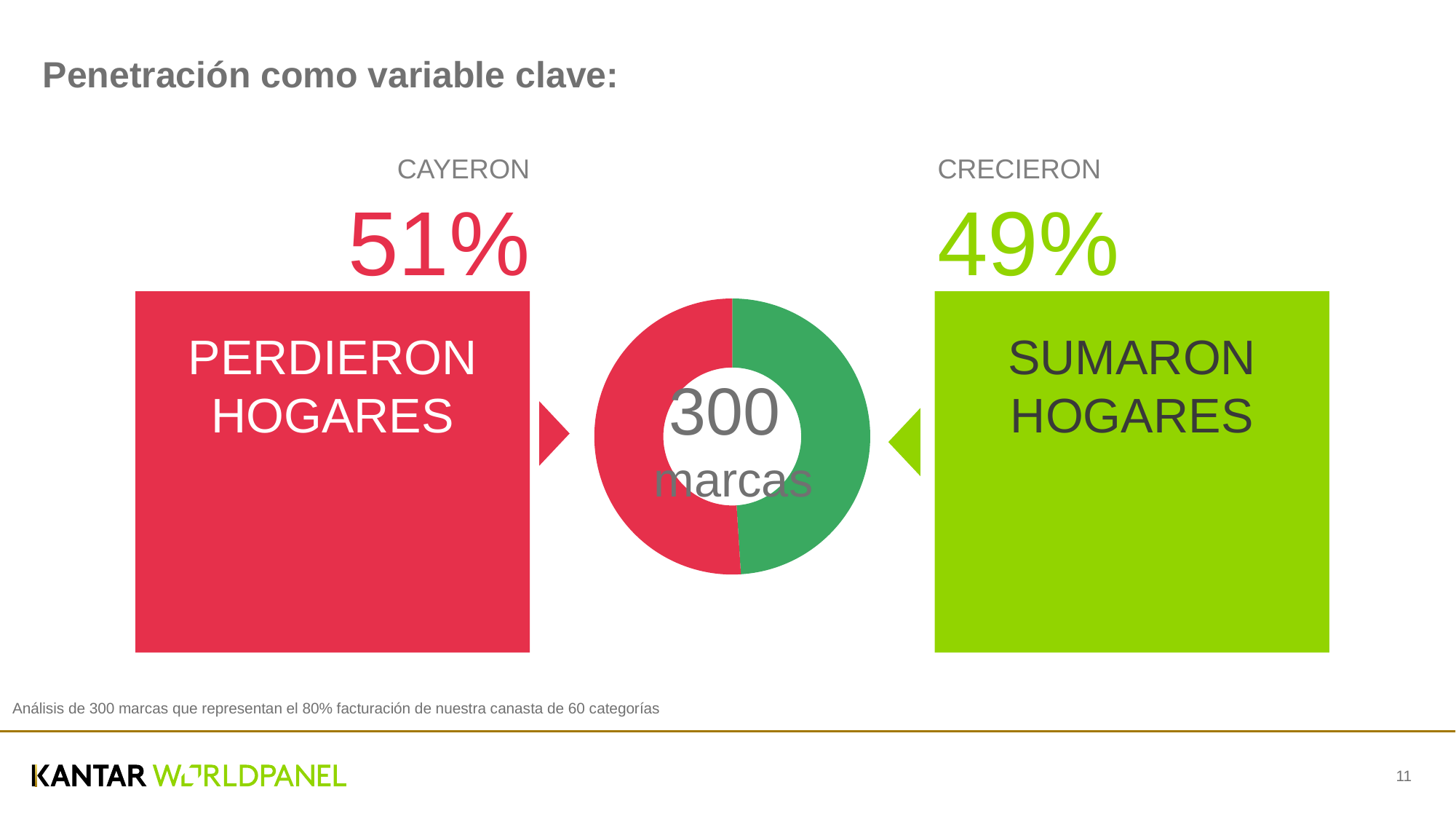
What share of brands fell (CAYERON) according to the slide? 51% What is the share of the donut chart taken by the brands that lost households (PERDIERON HOGARES)? 51% Which slice of the donut chart is the smallest? CRECIERON (49%) What kind of chart is shown in the centre of the slide? Pie chart (donut) What colour is the slice representing the brands that grew (CRECIERON)? Green What is the difference in percentage points between the share of brands that fell and the share that grew? 2 percentage points How many slices does the donut chart have? 2 Which slice of the donut chart is the largest? CAYERON (51%) Which group is larger: the brands that fell (CAYERON) or the brands that grew (CRECIERON)? CAYERON What share of brands grew (CRECIERON) according to the slide? 49% What text is shown in the centre of the donut chart? 300 marcas